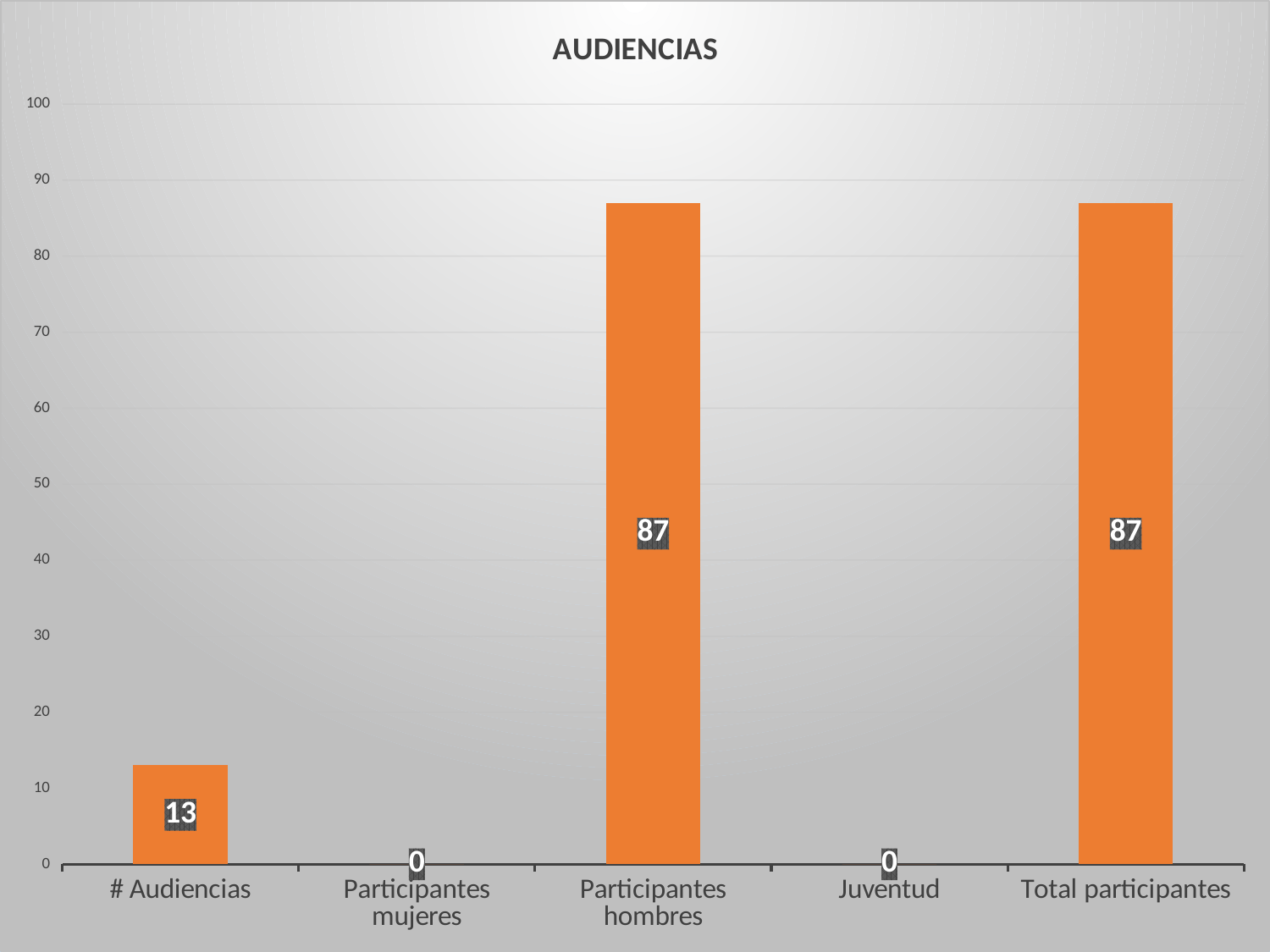
What is the title of the chart? AUDIENCIAS What is the value for Participantes hombres? 87 What kind of chart is this? bar chart What is the difference between Participantes hombres and # Audiencias? 74 What is the value for Juventud? 0 What is the value for Participantes mujeres? 0 What is the value for Total participantes? 87 Which is larger, # Audiencias or Participantes hombres? Participantes hombres Is the value for Total participantes greater or less than 80? greater Is the value for # Audiencias greater or less than 20? less What is the value for # Audiencias? 13 How many categories are shown on the x axis? 5